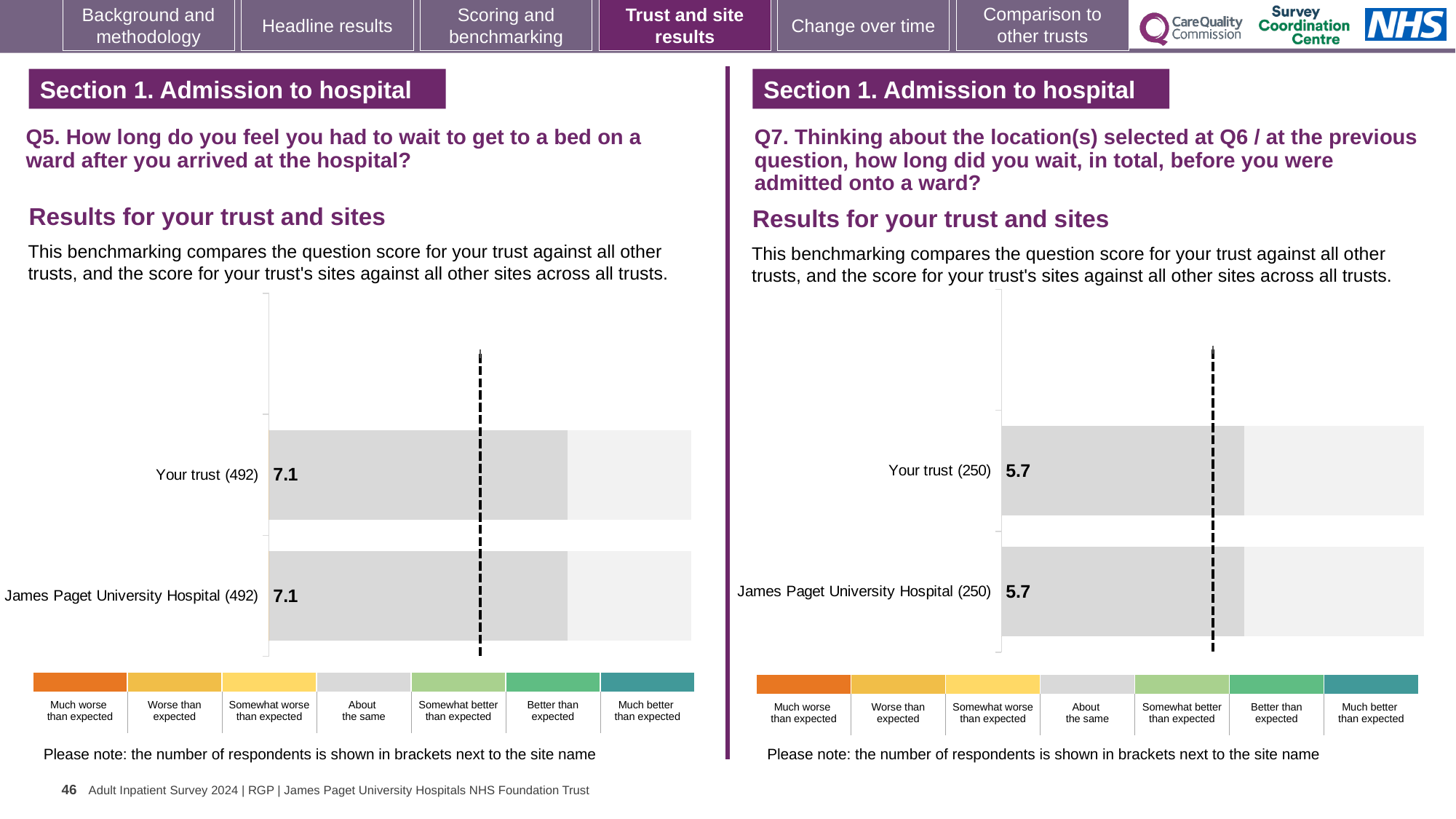
In the Q7 chart on the right, what is the score for James Paget University Hospital? 5.7 In the Q7 chart on the right, how many respondents are shown in brackets next to James Paget University Hospital? 250 How many bars are plotted in the Q5 chart on the left? 2 What kind of chart is the Q5 chart on the left? Bar chart In the Q5 chart on the left, what is the score for James Paget University Hospital? 7.1 In the Q5 chart on the left, what is the difference between the score for Your trust and the score for James Paget University Hospital? 0 In the Q5 chart on the left, how many respondents are shown in brackets next to Your trust? 492 How many bars are plotted in the Q7 chart on the right? 2 Is the score for Your trust in the Q7 chart on the right larger or smaller than the score for Your trust in the Q5 chart on the left? Smaller In the Q7 chart on the right, what is the difference between the score for Your trust and the score for James Paget University Hospital? 0 In the Q7 chart on the right, what is the score for Your trust? 5.7 In the Q5 chart on the left, what is the score for Your trust? 7.1